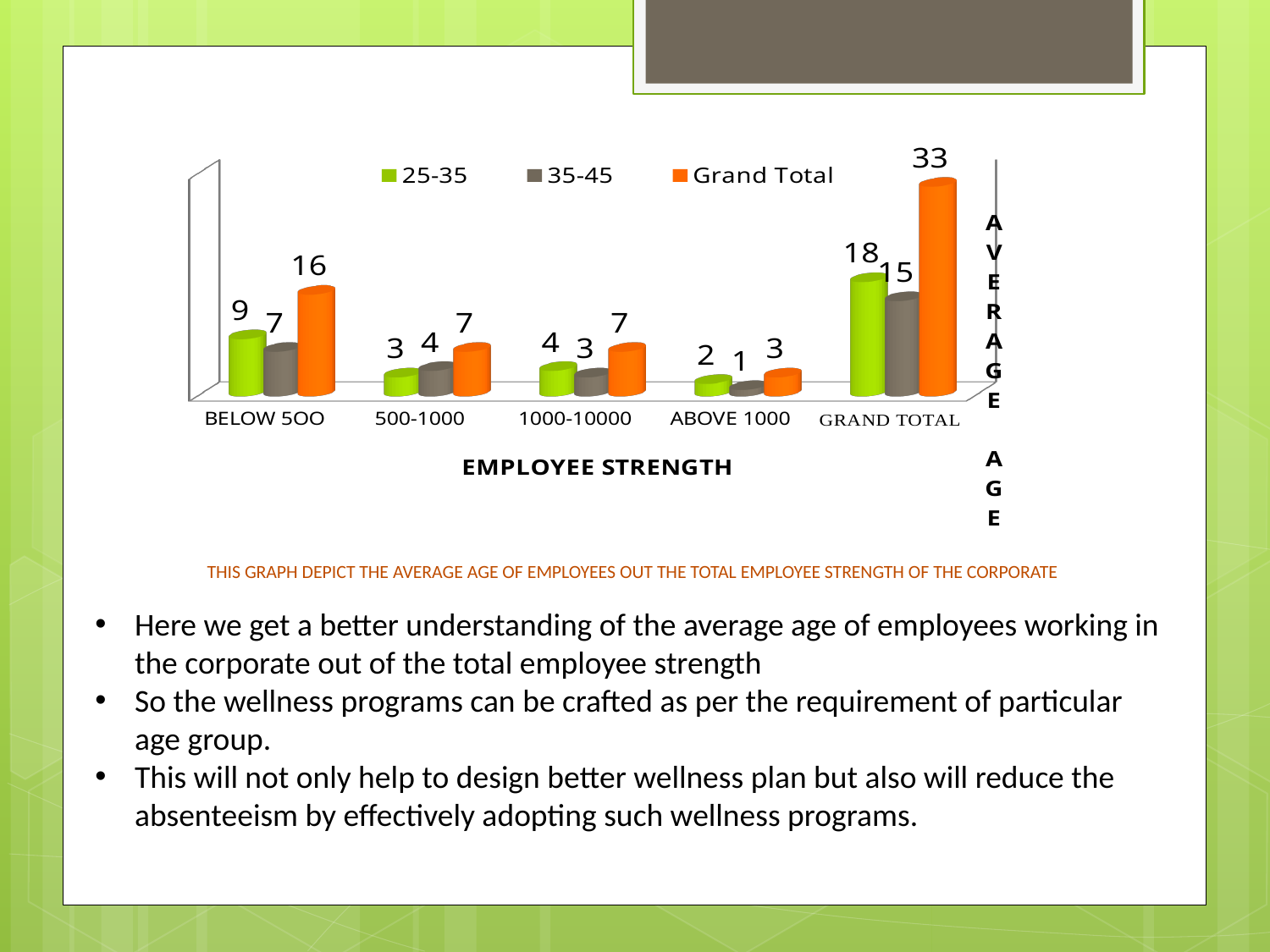
What is the Grand Total value for the GRAND TOTAL category? 33 What is the x-axis title of the chart? EMPLOYEE STRENGTH What is the difference between the 25-35 and 35-45 values in the GRAND TOTAL category? 3 Which category has the highest Grand Total value? GRAND TOTAL How many categories are shown on the x axis? 5 In the 500-1000 category, which is larger: the 25-35 value or the 35-45 value? 35-45 Which category has the lowest value for the 25-35 series? ABOVE 1000 What kind of chart is shown on the slide? Bar chart What is the Grand Total value for the 500-1000 category? 7 How many series does the legend list? 3 What is the value for 35-45 in the ABOVE 1000 category? 1 What is the value for 25-35 in the BELOW 5OO category? 9